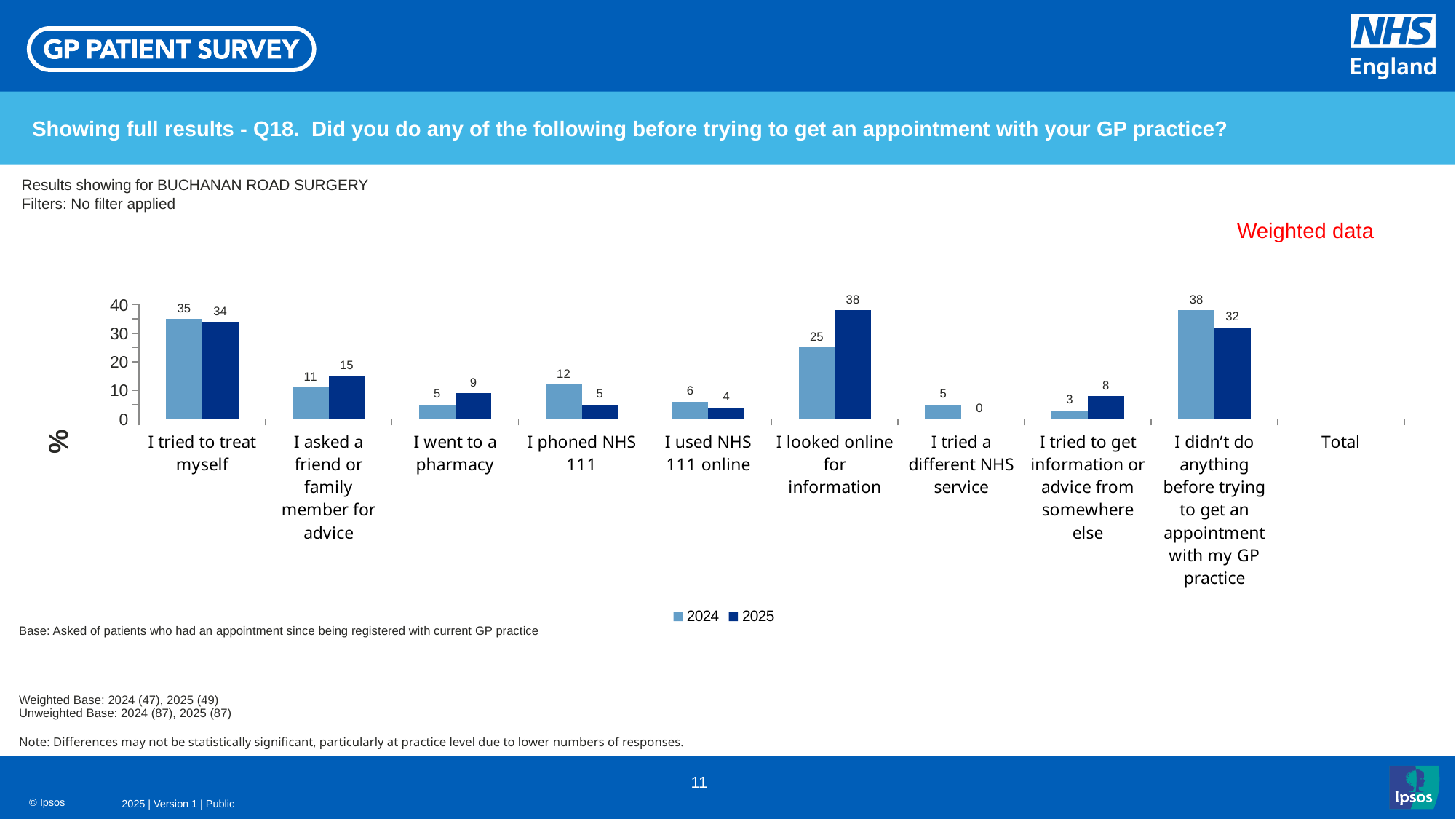
What is the difference between the 2024 and 2025 values for 'I looked online for information'? 13 What is the 2024 value for 'I tried to treat myself'? 35 What kind of chart is shown on the slide? Bar chart Which two years are listed in the chart legend? 2024 and 2025 Which is larger for 'I asked a friend or family member for advice': the 2024 value or the 2025 value? 2025 What is the 2025 value for 'I tried a different NHS service'? 0 How many series does the legend list? 2 What is the difference between the 2024 and 2025 values for 'I phoned NHS 111'? 7 Is the 2025 value for 'I didn't do anything before trying to get an appointment with my GP practice' greater or less than 30? greater What is the 2025 value for 'I looked online for information'? 38 Which category has the highest 2024 value? I didn't do anything before trying to get an appointment with my GP practice Which category has the lowest 2025 value? I tried a different NHS service